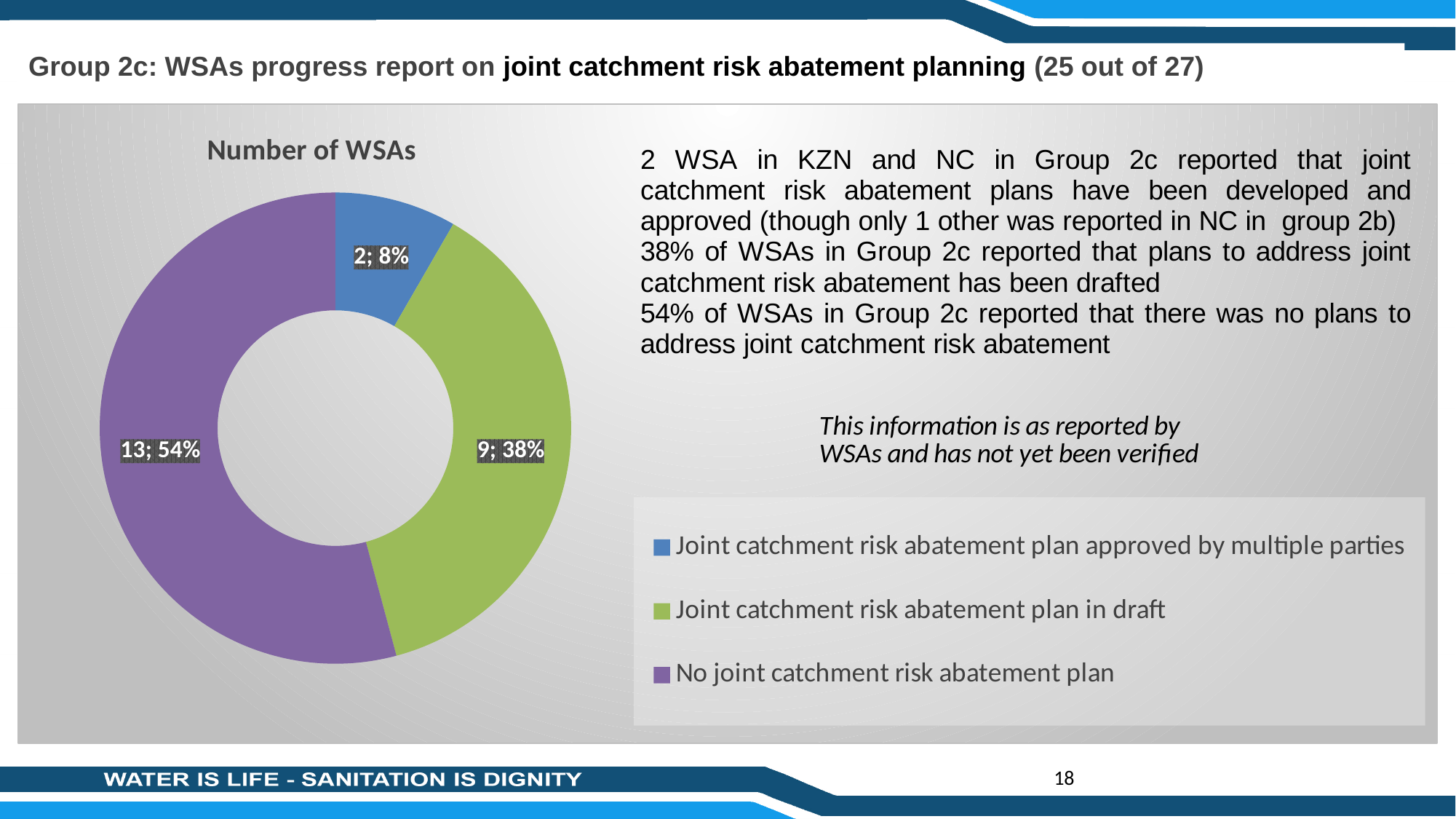
Which category has the largest slice? No joint catchment risk abatement plan Which category has the smallest slice? Joint catchment risk abatement plan approved by multiple parties How many WSAs reported a joint catchment risk abatement plan approved by multiple parties? 2 What is the title of the chart? Number of WSAs How many WSAs reported no joint catchment risk abatement plan? 13 What kind of chart is shown on the slide? Pie chart (doughnut) How many WSAs reported a joint catchment risk abatement plan in draft? 9 What is the difference in number of WSAs between 'No joint catchment risk abatement plan' and 'Joint catchment risk abatement plan in draft'? 4 What share of the pie is 'Joint catchment risk abatement plan approved by multiple parties'? 8% How many categories does the legend list? 3 What share of the pie is 'No joint catchment risk abatement plan'? 54% What share of the pie is 'Joint catchment risk abatement plan in draft'? 38%